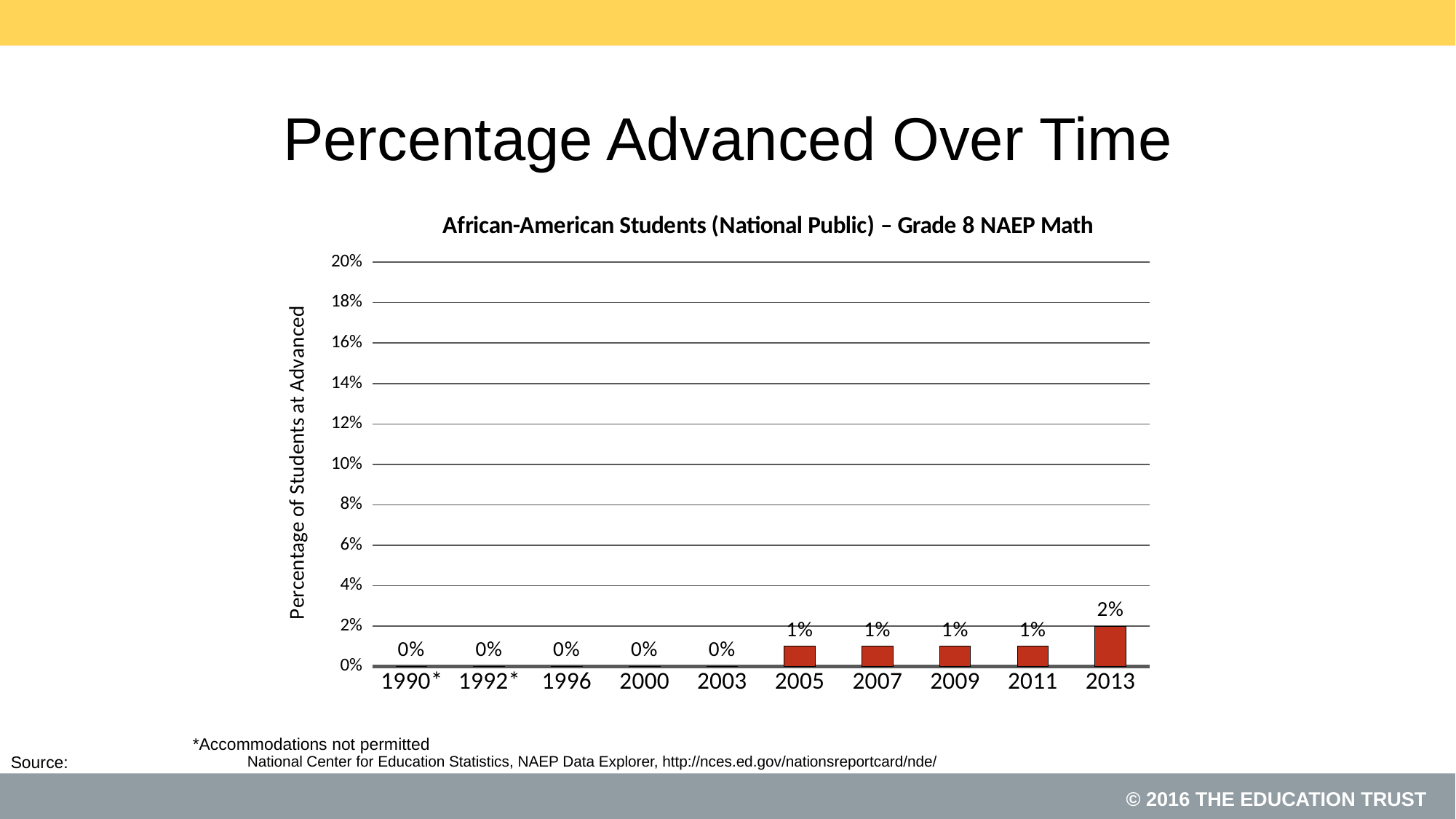
What is the y-axis label? Percentage of Students at Advanced Do the values generally rise or fall from 1990 to 2013? rise Which is larger, the value for 2003 or the value for 2007? 2007 What kind of chart is this? bar chart What is the value for 2005? 1% Which year has the highest percentage of students at Advanced? 2013 Is the value for 2013 greater or less than 4%? less How many years are shown on the x axis? 10 What is the value for 2000? 0% What is the chart's title? African-American Students (National Public) – Grade 8 NAEP Math What is the difference between the values for 2013 and 2011? 1% What is the value for 2013? 2%